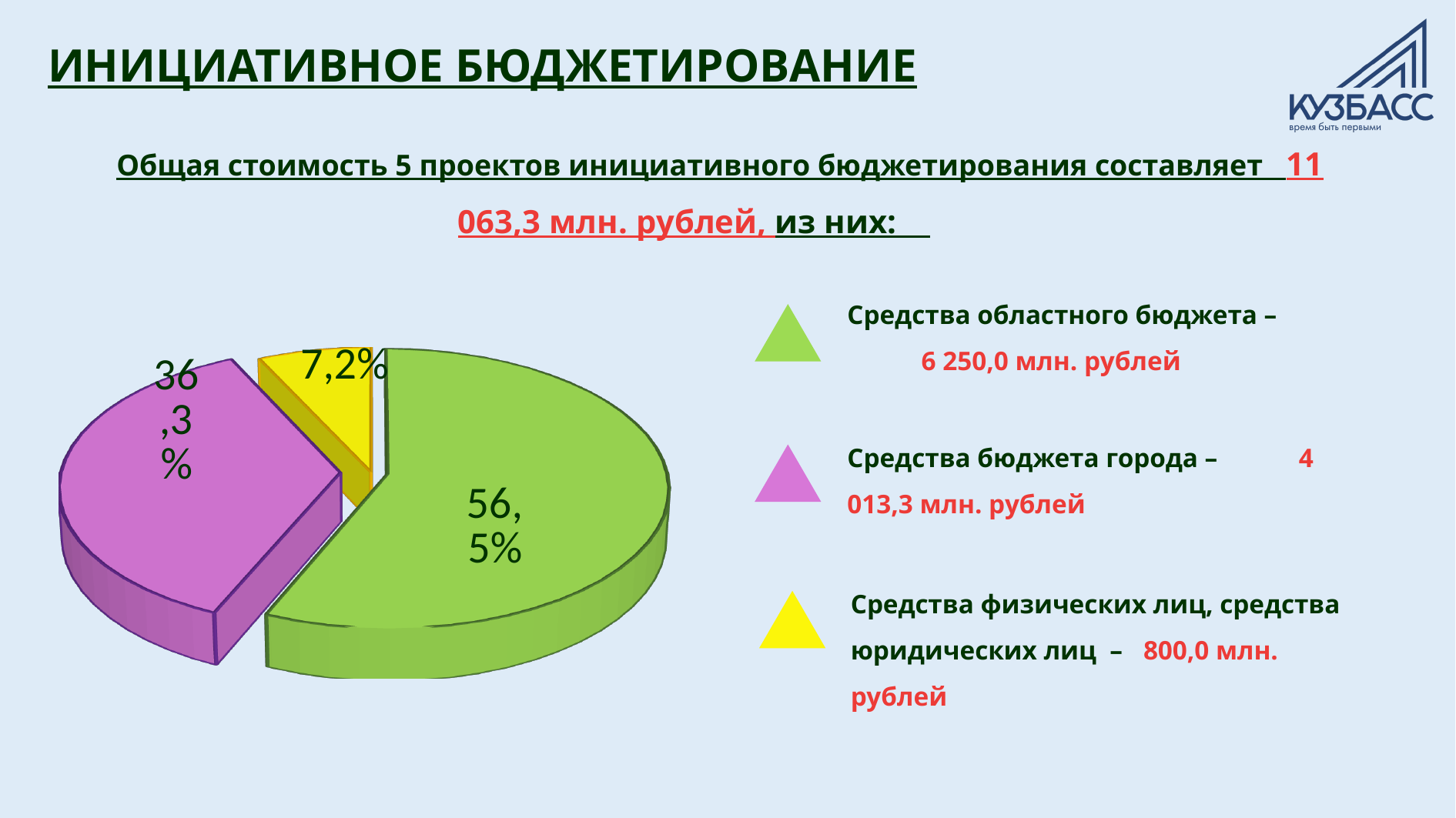
According to the legend, what amount corresponds to Средства физических лиц, средства юридических лиц? 800,0 млн. рублей What share of the pie does the yellow slice (Средства физических лиц, средства юридических лиц) represent? 7,2% According to the legend, what amount corresponds to Средства областного бюджета? 6 250,0 млн. рублей What share of the pie does the purple slice (Средства бюджета города) represent? 36,3% What colour is the slice representing Средства бюджета города? purple How many slices does the pie chart have? 3 Which funding source has the smallest share of the pie? Средства физических лиц, средства юридических лиц Which is larger: the share for Средства бюджета города or the share for Средства физических лиц, средства юридических лиц? Средства бюджета города What is the difference in percentage points between the green slice (56,5%) and the purple slice (36,3%)? 20,2 percentage points What kind of chart is shown on the slide? pie chart What share of the pie does the green slice (Средства областного бюджета) represent? 56,5% Which funding source has the largest share of the pie? Средства областного бюджета